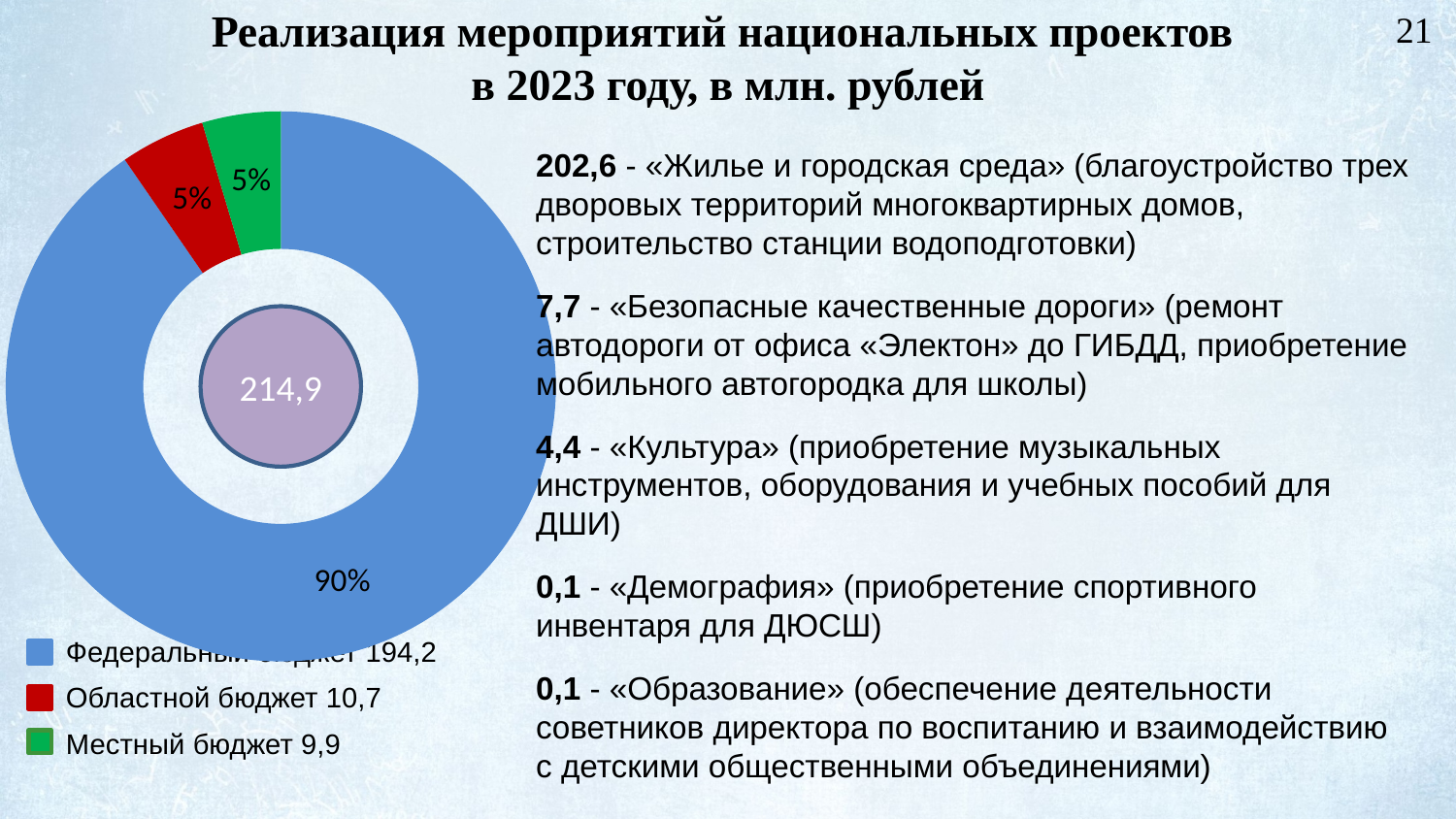
What is the value for Местный бюджет? 9,9 What kind of chart is shown on the slide? doughnut chart What share of the chart does Областной бюджет take? 5% How many categories does the chart show? 3 Which category has the lowest value? Местный бюджет What is the value for Областной бюджет? 10,7 Which is larger, Областной бюджет or Местный бюджет? Областной бюджет What share of the chart does Федеральный бюджет take? 90% What colour represents Местный бюджет in the chart? green What is the value for Федеральный бюджет? 194,2 What is the difference between Федеральный бюджет and Областной бюджет? 183,5 Which category has the highest value? Федеральный бюджет